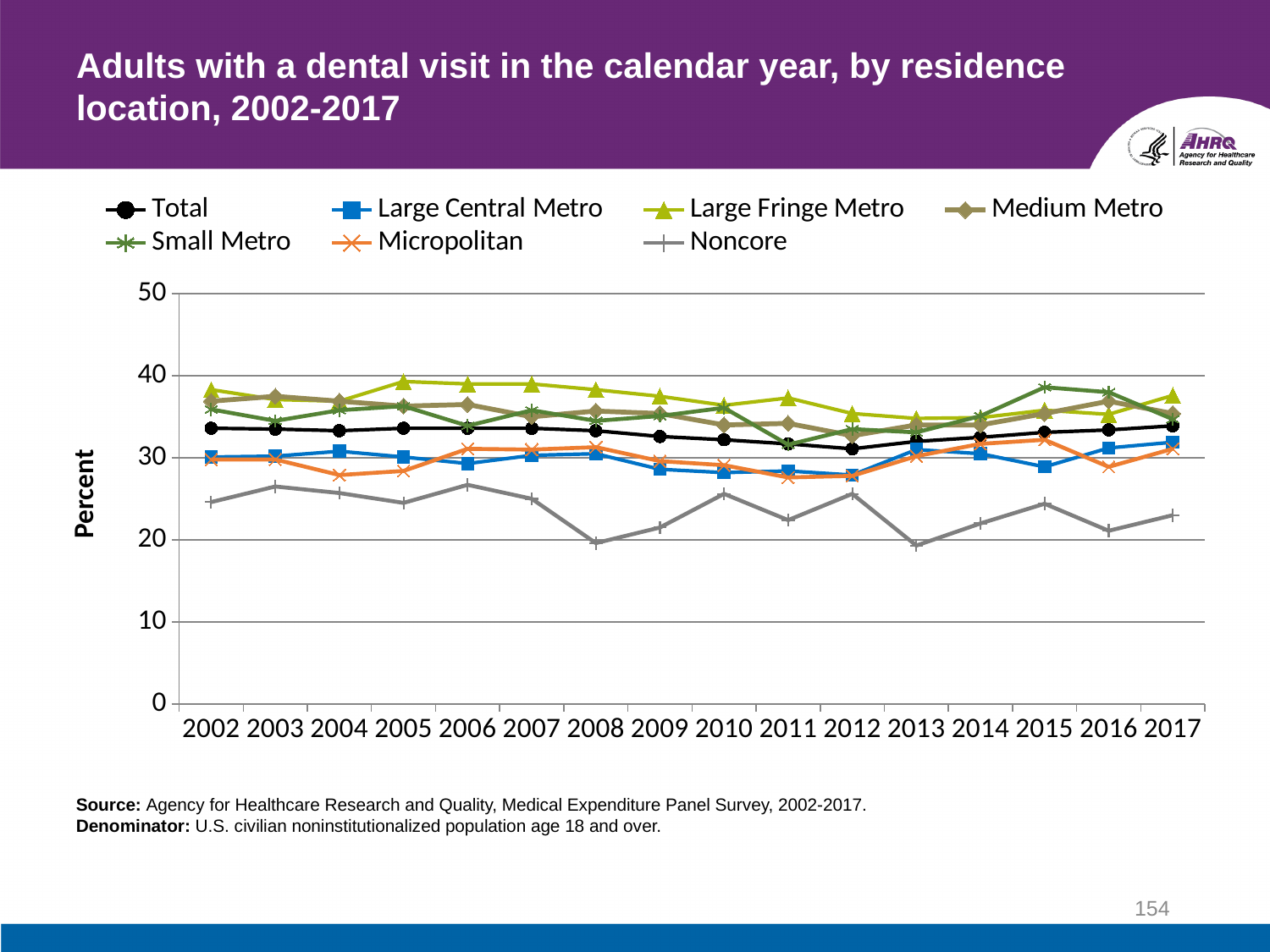
Does the Noncore series rise or fall from 2012 to 2013? fall Which series has the highest value in 2005? Large Fringe Metro What kind of chart is shown on the slide? Line chart Which series has the lowest value in 2013? Noncore Is the value for Large Fringe Metro in 2005 greater or less than 30? greater Which series has the highest value in 2015? Small Metro How many series does the legend list? 7 Which is larger in 2008, the value for Large Fringe Metro or the value for Noncore? Large Fringe Metro What is the label on the y axis? Percent How many years are shown along the x axis? 16 Is the value for Total in 2002 greater or less than 30? greater Is the value for Noncore in 2002 greater or less than 30? less